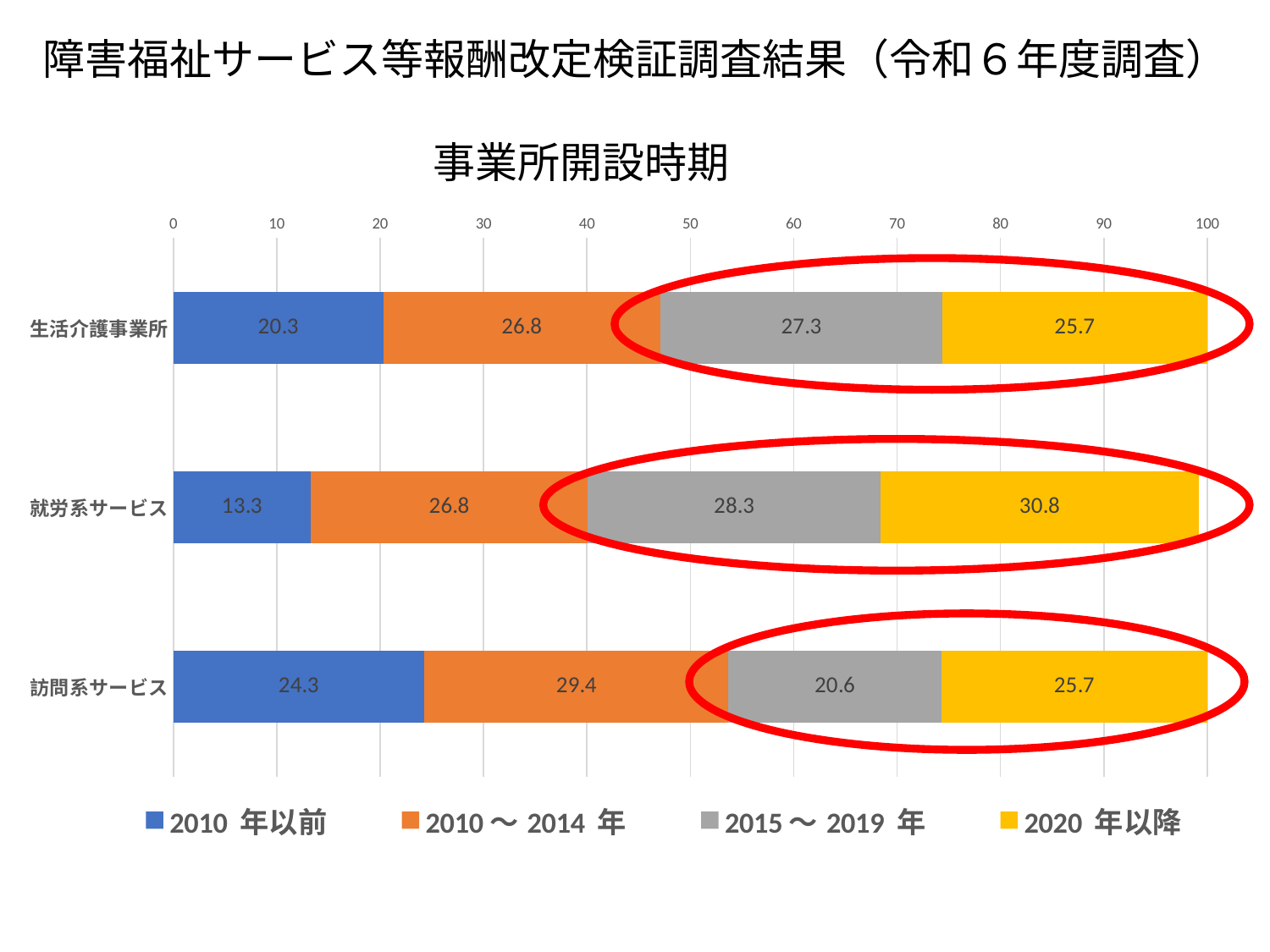
What is the value for 2010年以前 for 生活介護事業所? 20.3 Which category has the highest value for 2010年以前? 訪問系サービス What is the difference between the 2020年以降 values for 就労系サービス and 生活介護事業所? 5.1 What is the title of the chart? 事業所開設時期 Which is larger: the 2010～2014年 value for 訪問系サービス or for 就労系サービス? 訪問系サービス Which category has the lowest value for 2015～2019年? 訪問系サービス How many series does the legend list? 4 What is the value for 2015～2019年 for 訪問系サービス? 20.6 How many categories are shown on the chart? 3 What is the value for 2020年以降 for 就労系サービス? 30.8 What kind of chart is shown on the slide? Stacked bar chart What is the total of the stacked bar for 訪問系サービス? 100.0